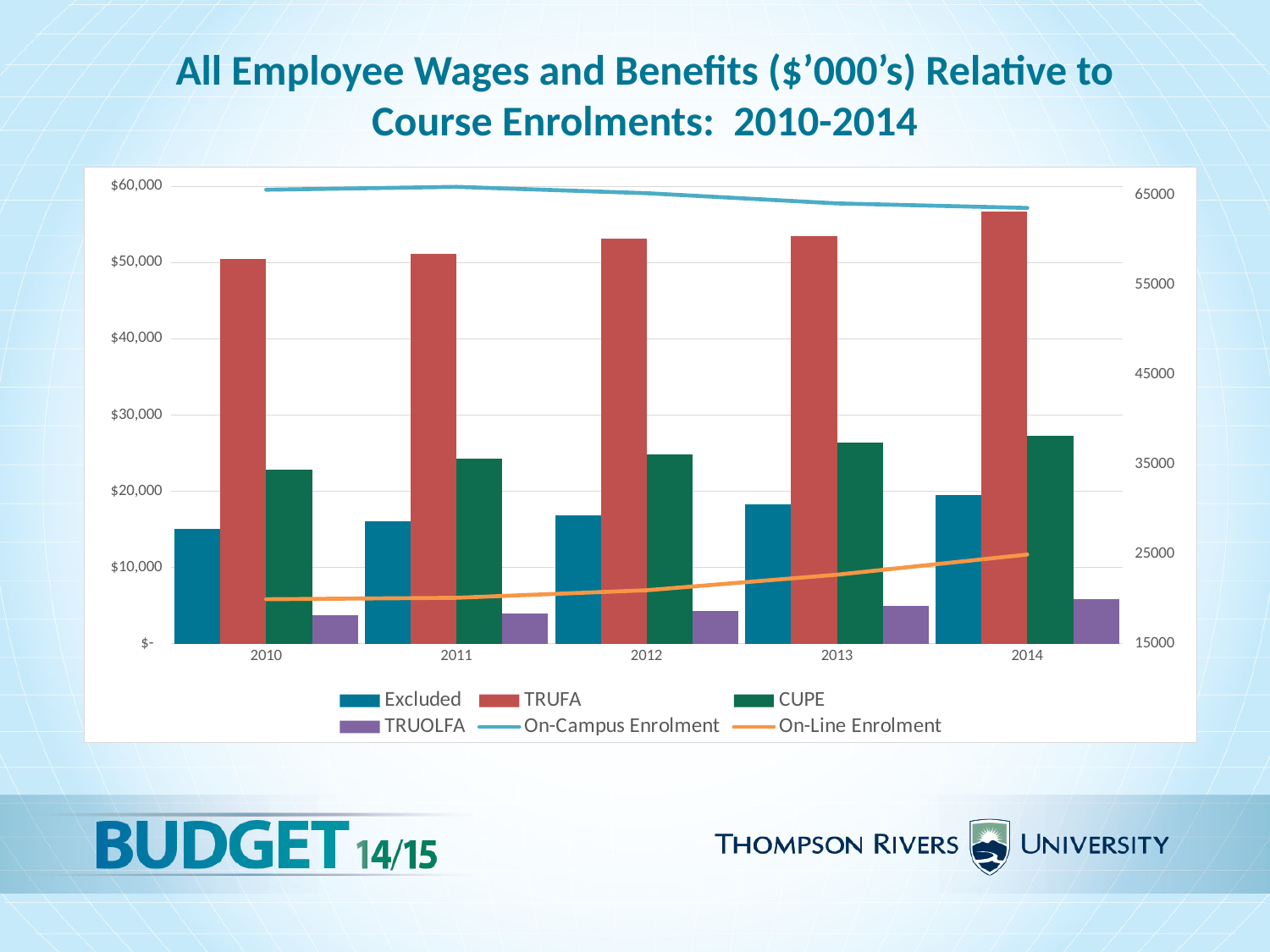
How many years are shown on the x axis? 5 Is the TRUOLFA value for 2014 greater or less than $10,000? less Which employee group has the highest wages and benefits bars in every year? TRUFA Is the Excluded value for 2010 greater or less than $20,000? less How many series does the legend list? 6 Which employee group has the lowest wages and benefits bars in every year? TRUOLFA Does the On-Line Enrolment line rise or fall from 2010 to 2014? rise Is the CUPE value for 2014 greater or less than $30,000? less Does the On-Campus Enrolment line rise or fall from 2010 to 2014? fall In 2014, which is larger: the CUPE bar or the Excluded bar? CUPE What kind of chart is shown on the slide? A bar chart combined with line series